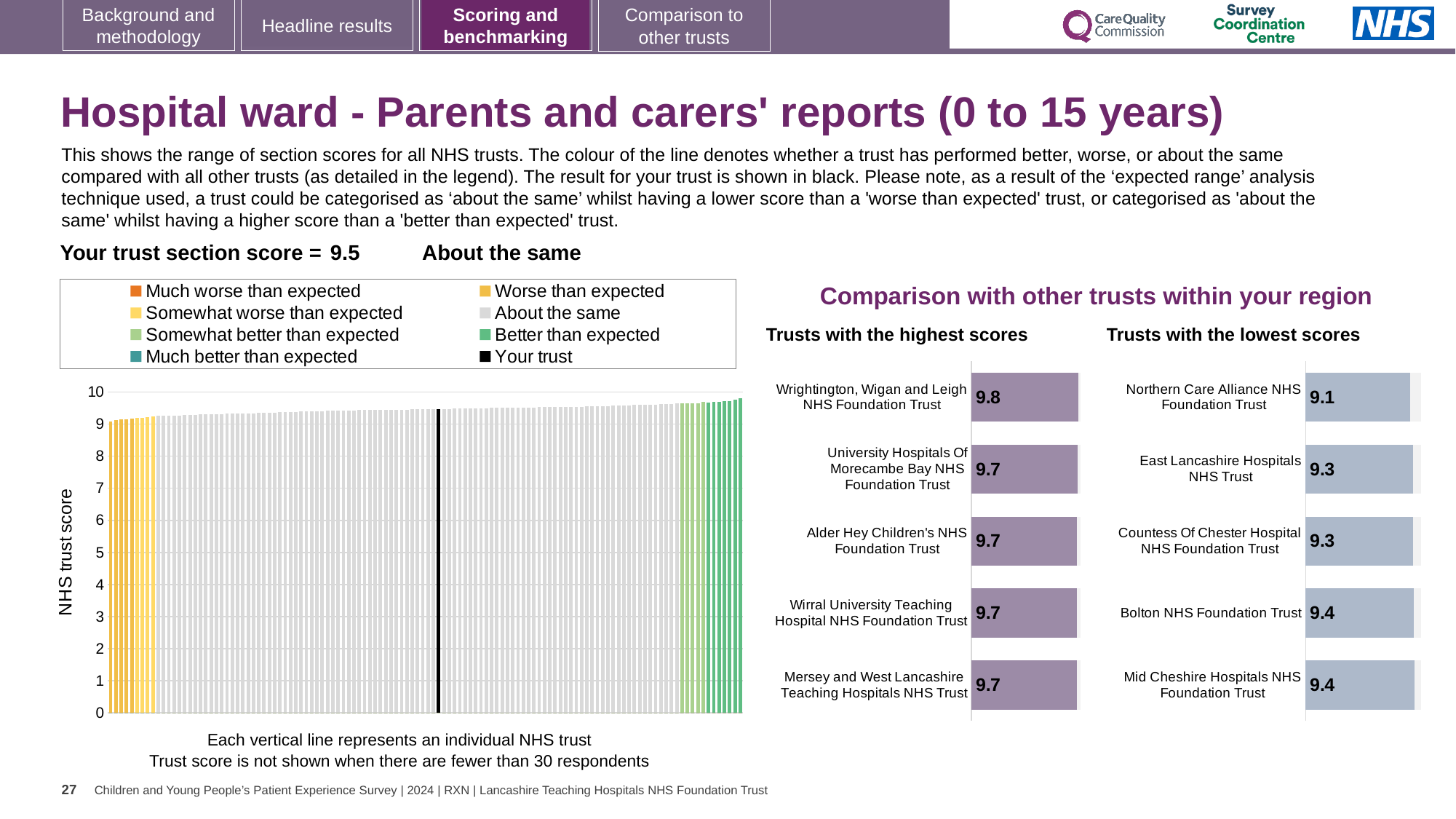
In the 'Trusts with the lowest scores' chart, what is the score for Bolton NHS Foundation Trust? 9.4 In the 'Trusts with the highest scores' chart, what is the difference between the scores of Wrightington, Wigan and Leigh NHS Foundation Trust and Alder Hey Children's NHS Foundation Trust? 0.1 In the 'Trusts with the highest scores' chart, which trust has the highest score? Wrightington, Wigan and Leigh NHS Foundation Trust In the large chart on the left, do the bar values rise or fall from left to right along the x axis? Rise In the 'Trusts with the lowest scores' chart, what is the difference between the scores of Bolton NHS Foundation Trust and Northern Care Alliance NHS Foundation Trust? 0.3 In the 'Trusts with the lowest scores' chart, what is the score for Northern Care Alliance NHS Foundation Trust? 9.1 How many trusts are listed in the 'Trusts with the highest scores' chart? 5 What kind of chart is the large chart on the left showing the range of section scores for all NHS trusts? Bar chart In the 'Trusts with the lowest scores' chart, which trust has the lowest score? Northern Care Alliance NHS Foundation Trust In the 'Trusts with the highest scores' chart, what is the score for Wrightington, Wigan and Leigh NHS Foundation Trust? 9.8 How many entries does the legend above the large chart on the left list? 8 In the 'Trusts with the lowest scores' chart, which has the larger score: East Lancashire Hospitals NHS Trust or Bolton NHS Foundation Trust? Bolton NHS Foundation Trust